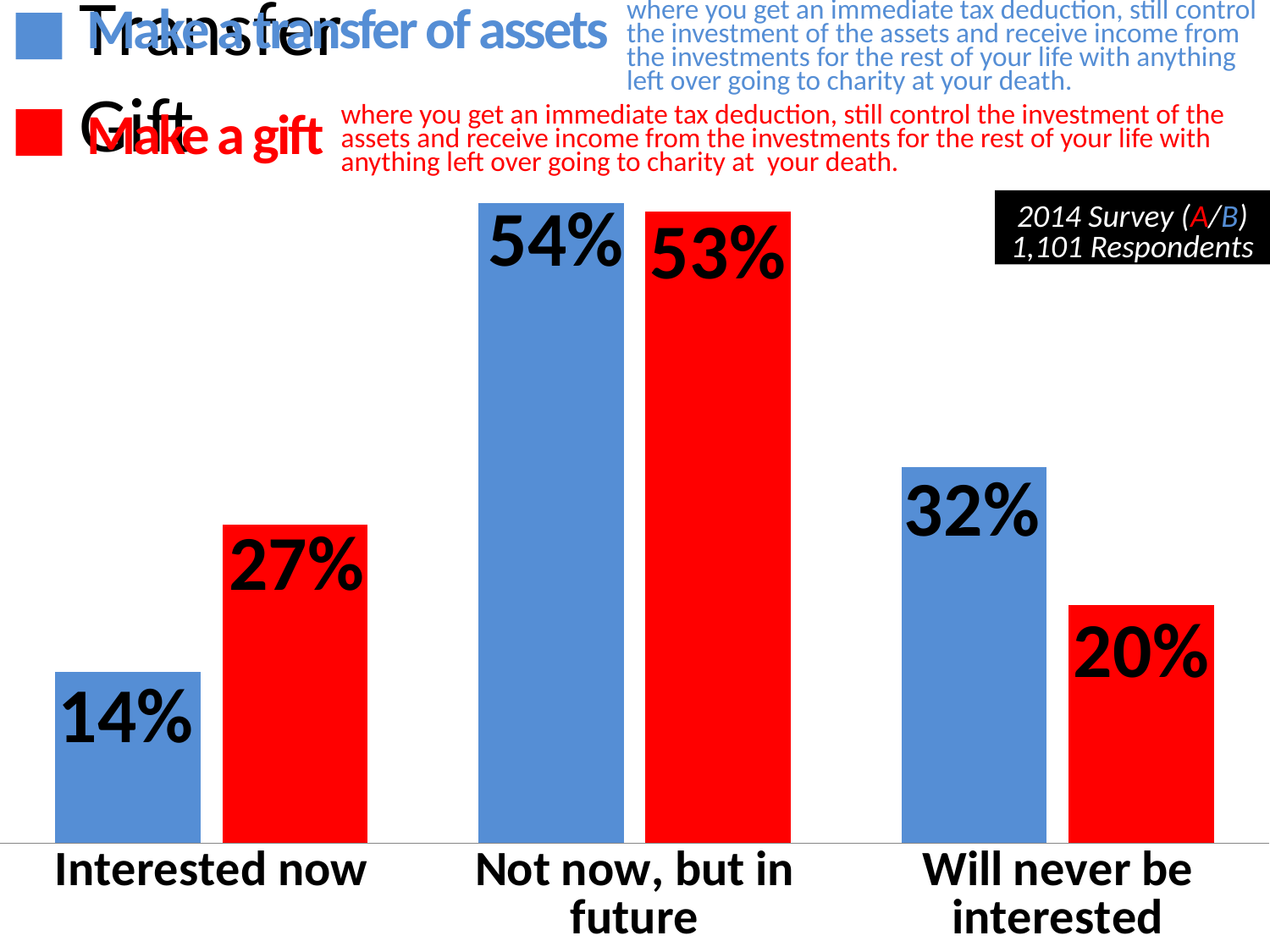
How many series does the chart show? 2 Which category has the highest value for the blue (Transfer) series? Not now, but in future For "Interested now", which is larger: the blue (Transfer) bar or the red (Gift) bar? the red (Gift) bar How many categories are shown on the x axis? 3 What is the value of the blue (Transfer) bar for "Not now, but in future"? 54% What is the difference between the blue (Transfer) and red (Gift) values for "Will never be interested"? 12% What is the value of the blue (Transfer) bar for "Interested now"? 14% What is the value of the red (Gift) bar for "Interested now"? 27% How many respondents does the survey note on the slide say there were? 1,101 What kind of chart is shown on the slide? bar chart Which category has the lowest value for the red (Gift) series? Will never be interested What is the value of the red (Gift) bar for "Will never be interested"? 20%